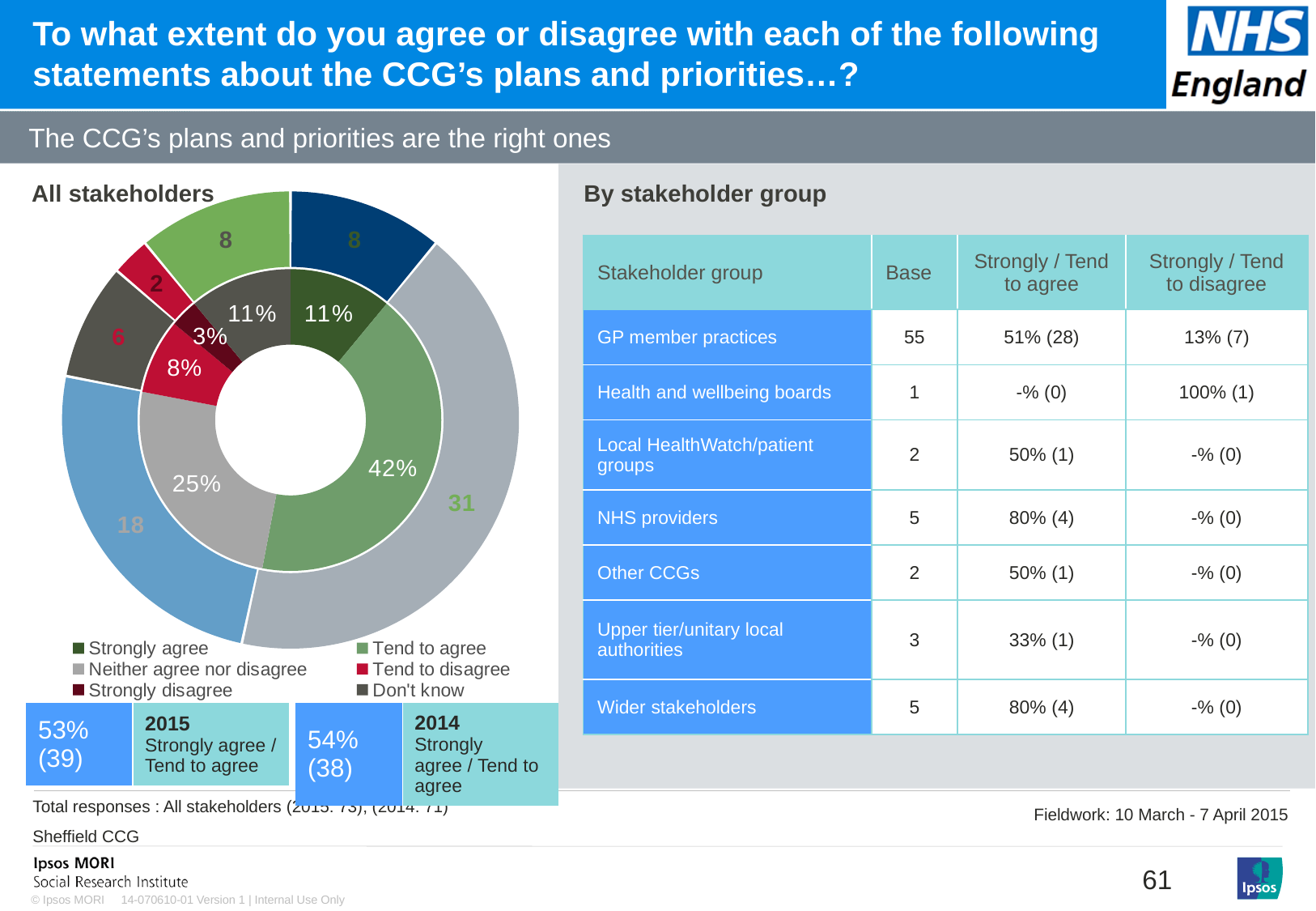
What type of chart is used to show the 'All stakeholders' results? Doughnut chart In the 'All stakeholders' chart, what percentage of respondents 'Tend to disagree'? 8% What percentage of all stakeholders strongly agreed or tended to agree in 2015, according to the summary box below the chart? 53% (39) In the 'All stakeholders' chart, which is larger: the share for 'Tend to disagree' or the share for 'Don't know'? Don't know How many response categories does the legend of the 'All stakeholders' chart list? 6 In the 'All stakeholders' chart, what percentage of respondents 'Strongly disagree'? 3% In the 'All stakeholders' chart, which response category has the largest share? Tend to agree In the 'All stakeholders' chart, what percentage of respondents 'Strongly agree'? 11% In the 'All stakeholders' chart, which response category has the smallest share? Strongly disagree In the 'All stakeholders' chart, what is the difference in percentage points between 'Tend to agree' and 'Neither agree nor disagree'? 17 percentage points In the 'All stakeholders' chart, what percentage of respondents 'Tend to agree'? 42% In the 'All stakeholders' chart, what percentage of respondents 'Neither agree nor disagree'? 25%